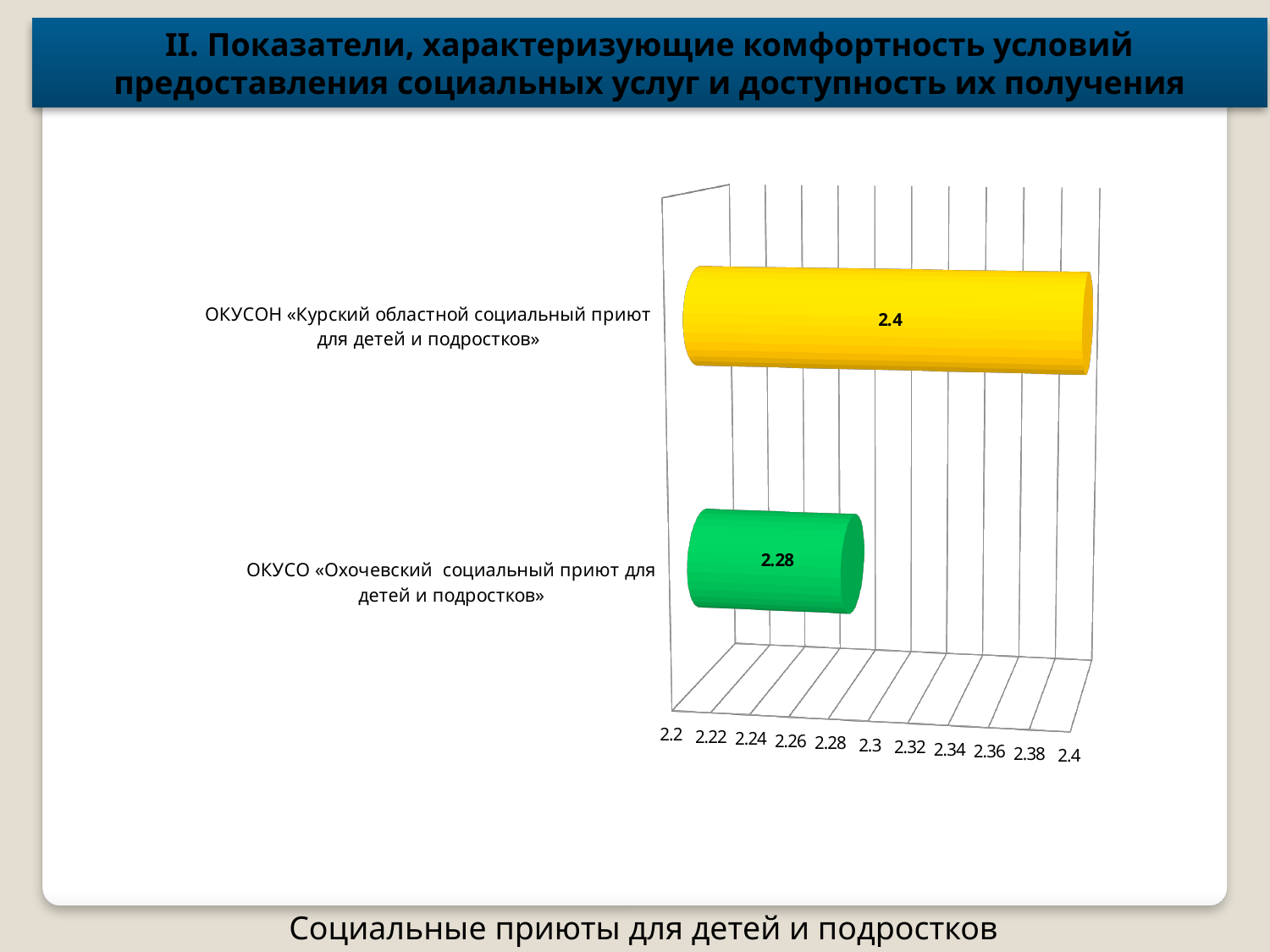
What is the difference between the values for ОКУСОН «Курский областной социальный приют для детей и подростков» and ОКУСО «Охочевский социальный приют для детей и подростков»? 0.12 Which category has the highest value? ОКУСОН «Курский областной социальный приют для детей и подростков» Is the value for ОКУСО «Охочевский социальный приют для детей и подростков» greater or less than 2.3? less What is the value for ОКУСО «Охочевский социальный приют для детей и подростков»? 2.28 Which has a larger value, ОКУСОН «Курский областной социальный приют для детей и подростков» or ОКУСО «Охочевский социальный приют для детей и подростков»? ОКУСОН «Курский областной социальный приют для детей и подростков» What is the minimum value shown on the value axis of the chart? 2.2 What colour is the bar for ОКУСОН «Курский областной социальный приют для детей и подростков»? yellow What is the value for ОКУСОН «Курский областной социальный приют для детей и подростков»? 2.4 Is the value for ОКУСОН «Курский областной социальный приют для детей и подростков» greater or less than 2.3? greater Which category has the lowest value? ОКУСО «Охочевский социальный приют для детей и подростков» How many categories are shown in the chart? 2 What kind of chart is shown on the slide? bar chart